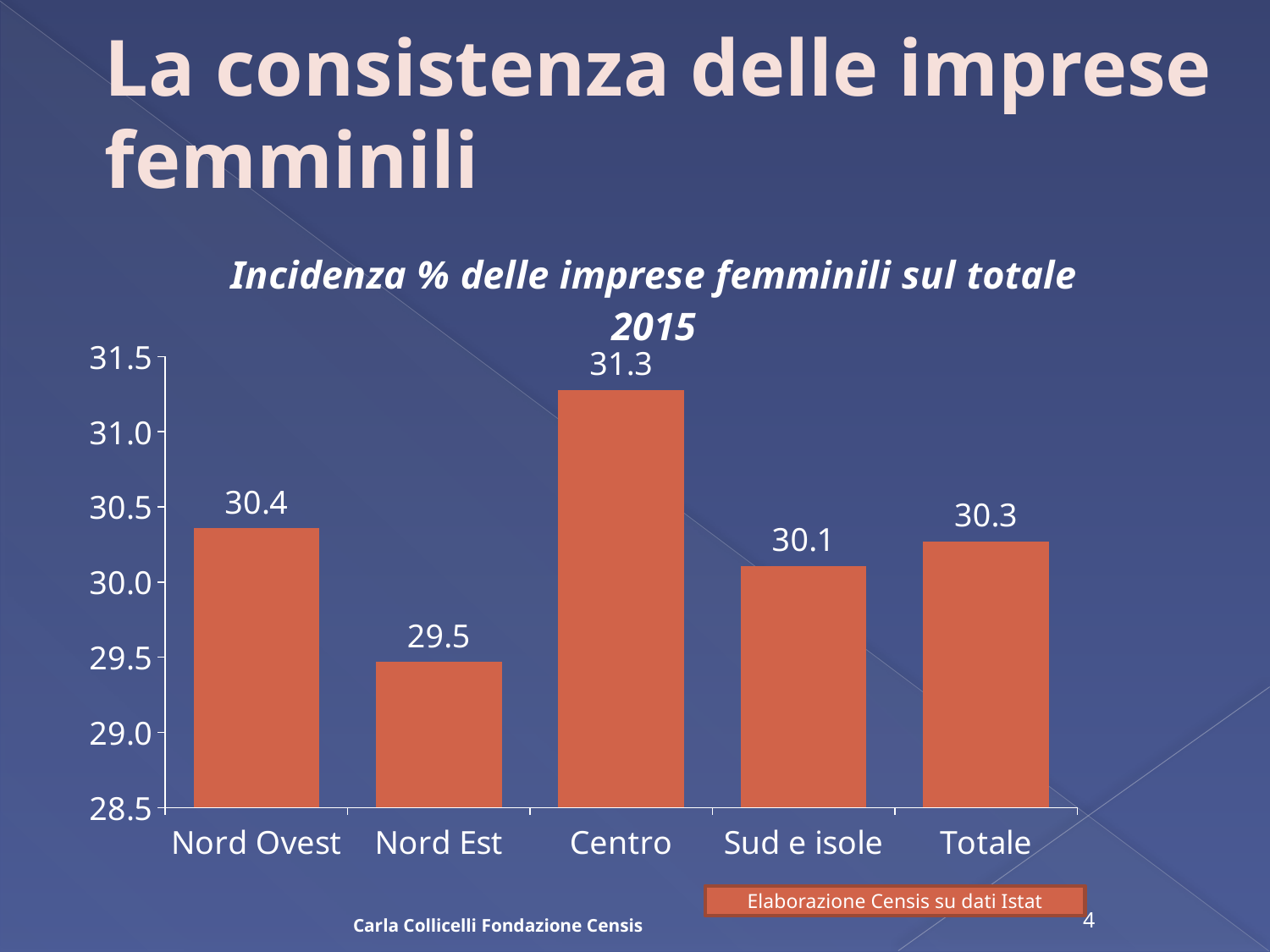
Which category has the highest value? Centro What is the value for Totale? 30.3 What is the value for Nord Est? 29.5 What kind of chart is shown on the slide? bar chart How many categories are shown on the x axis? 5 What is the difference between the values for Centro and Nord Est? 1.8 Is the value for Nord Est greater or less than 30.0? less What is the value for Sud e isole? 30.1 What is the title of the chart? Incidenza % delle imprese femminili sul totale 2015 Which category has the lowest value? Nord Est Which is larger, the value for Nord Ovest or the value for Sud e isole? Nord Ovest What is the value for Centro? 31.3